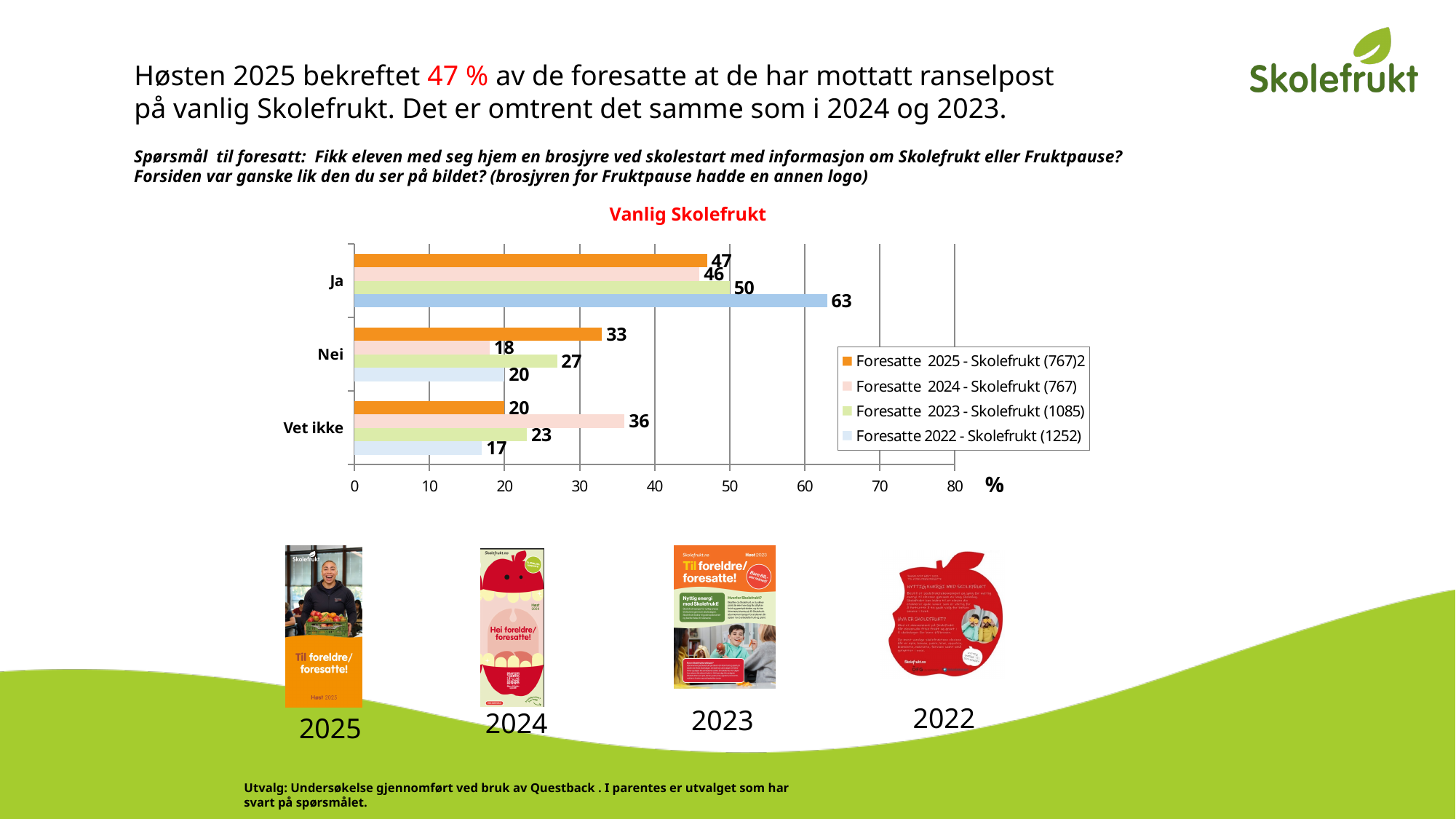
What is the difference between the "Ja" values for Foresatte 2022 and Foresatte 2025? 16 What is the value for "Nei" in the Foresatte 2024 series? 18 How many categories are shown on the y axis of the "Vanlig Skolefrukt" chart? 3 What is the value for "Vet ikke" in the Foresatte 2022 series? 17 What is the value for "Ja" in the Foresatte 2025 series? 47 Which is larger for "Vet ikke": the Foresatte 2024 value or the Foresatte 2023 value? Foresatte 2024 What kind of chart is shown under the title "Vanlig Skolefrukt"? bar chart Is the value for "Nei" in the Foresatte 2025 series greater or less than 30? greater Which series has the lowest value for "Nei"? Foresatte 2024 - Skolefrukt (767) What is the title of the chart on the slide? Vanlig Skolefrukt Which series has the highest value for "Ja"? Foresatte 2022 - Skolefrukt (1252) How many series does the legend of the "Vanlig Skolefrukt" chart list? 4